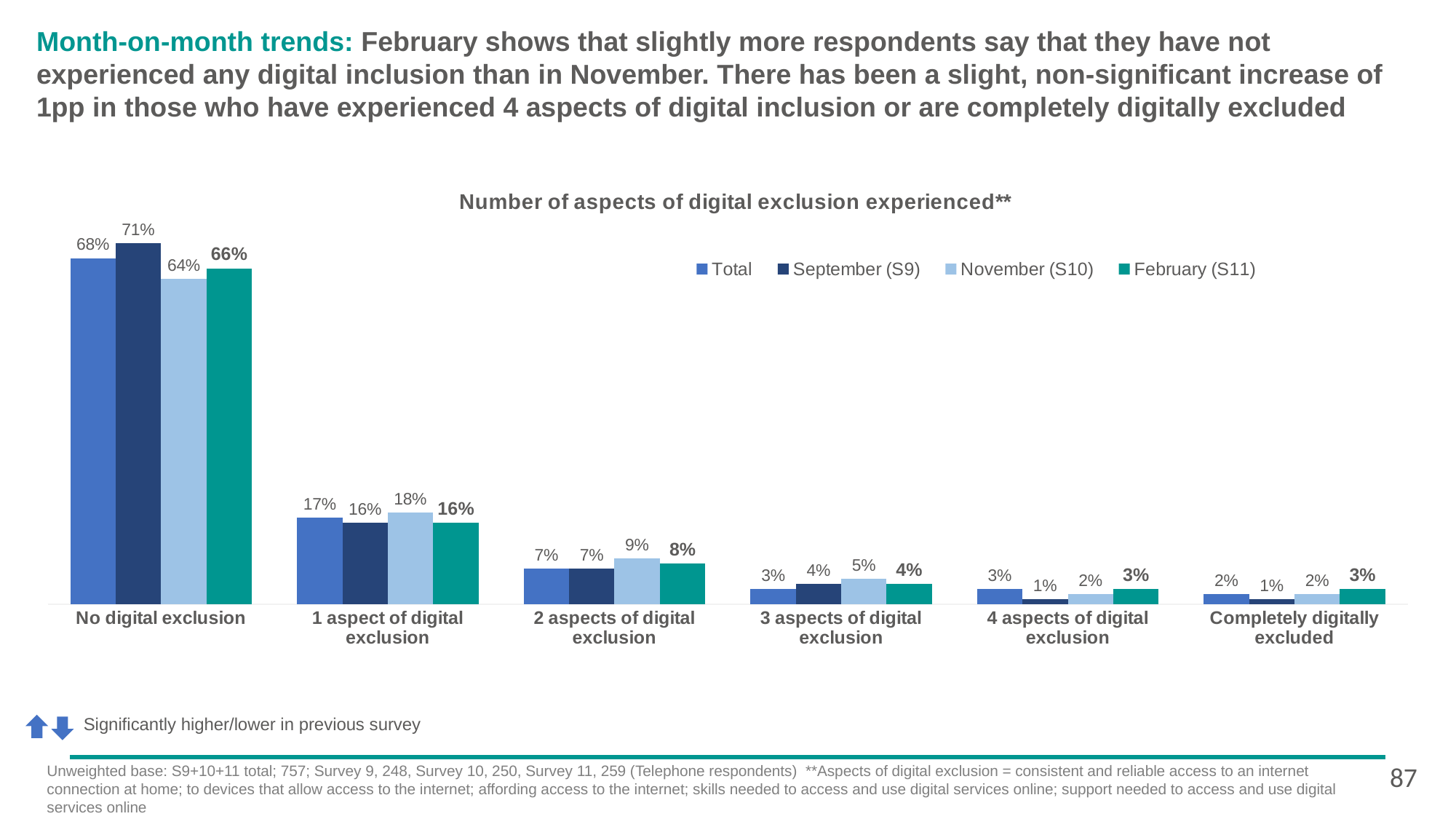
What is the November (S10) value for '1 aspect of digital exclusion'? 18% Which is larger for '3 aspects of digital exclusion': the November (S10) value or the February (S11) value? November (S10) What is the difference between the September (S9) and February (S11) values for 'No digital exclusion'? 5% What is the September (S9) value for '4 aspects of digital exclusion'? 1% What is the Total value for '2 aspects of digital exclusion'? 7% Which category has the highest September (S9) value? No digital exclusion Which category has the lowest Total value? Completely digitally excluded What is the title of the chart? Number of aspects of digital exclusion experienced** How many categories are shown on the x axis? 6 How many series does the legend list? 4 What is the February (S11) value for 'No digital exclusion'? 66% What kind of chart is shown on the slide? Bar chart